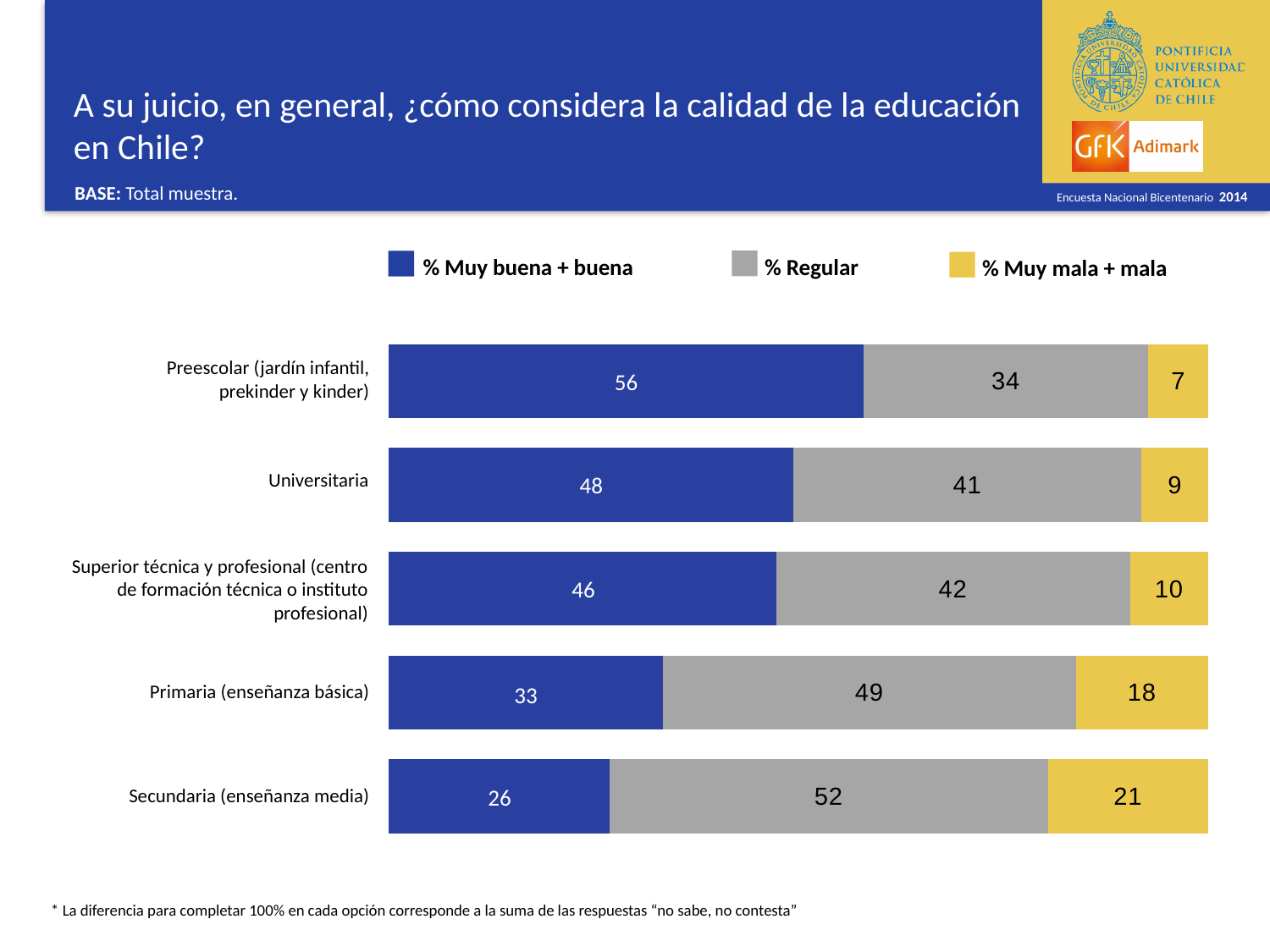
Which is larger: "% Muy buena + buena" for Universitaria or for Superior técnica y profesional? Universitaria Which category has the lowest value for "% Muy mala + mala"? Preescolar (jardín infantil, prekinder y kinder) What is the value of "% Muy buena + buena" for Universitaria? 48 Which category has the highest value for "% Muy buena + buena"? Preescolar (jardín infantil, prekinder y kinder) What kind of chart is shown on the slide? Stacked bar chart How many categories are shown in the chart? 5 What is the total of the three labelled segments for Primaria (enseñanza básica)? 100 What is the value of "% Muy mala + mala" for Secundaria (enseñanza media)? 21 Which colour represents "% Regular" in the chart? Grey What is the difference between the "% Regular" values for Secundaria (enseñanza media) and Preescolar (jardín infantil, prekinder y kinder)? 18 What is the value of "% Regular" for Primaria (enseñanza básica)? 49 How many series does the legend list? 3